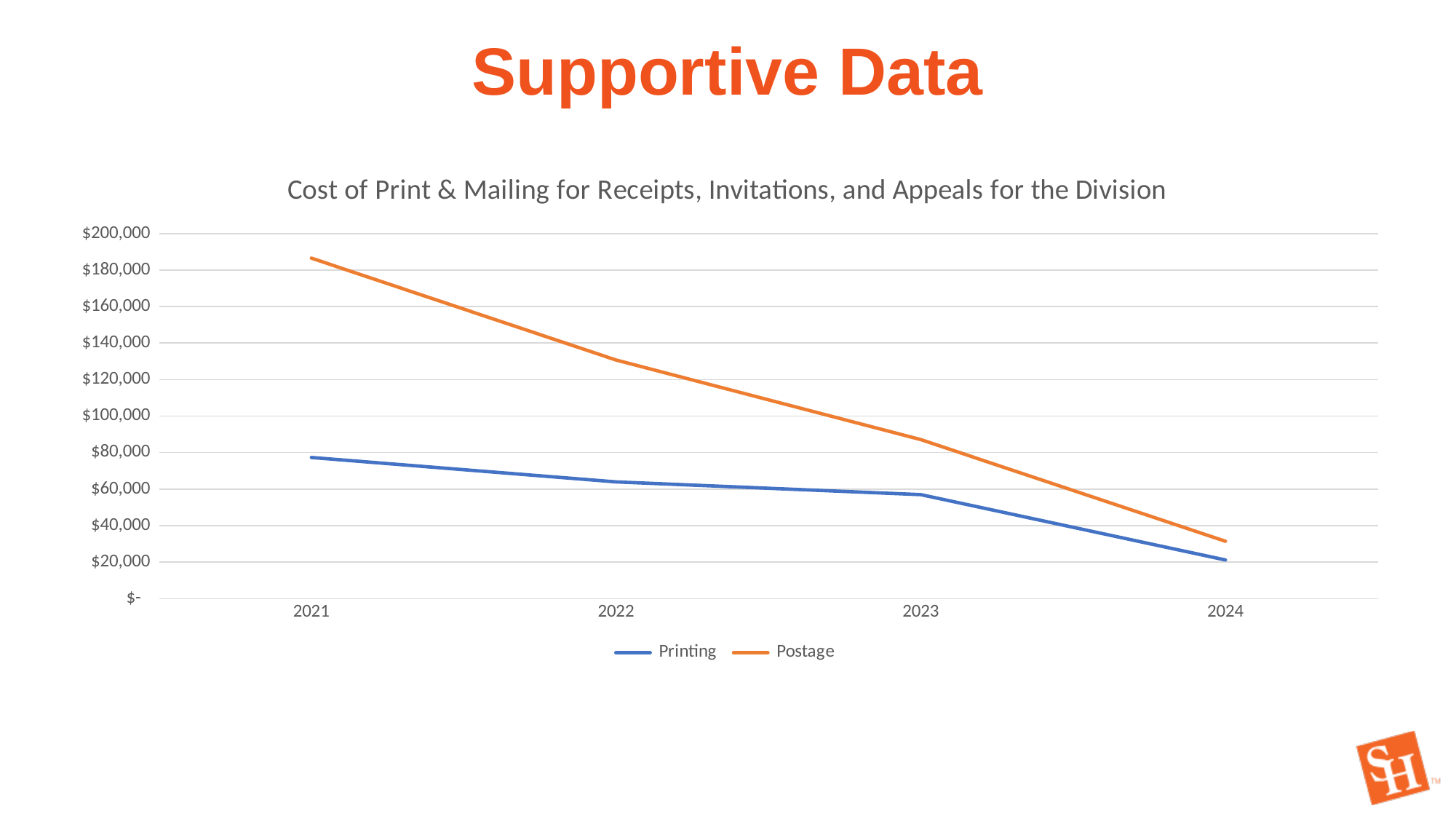
Does the Printing line rise or fall from 2021 to 2024? Fall Is the Printing value for 2024 greater or less than $40,000? less In which year is the Printing cost lowest? 2024 What is the title of the chart? Cost of Print & Mailing for Receipts, Invitations, and Appeals for the Division Does the Postage line rise or fall from 2021 to 2024? Fall In 2021, which is larger, the Printing cost or the Postage cost? Postage Is the Postage value for 2023 greater or less than $100,000? less How many series does the legend list? 2 What kind of chart is shown on the slide? Line chart How many years are plotted along the x axis? 4 In which year is the Postage cost highest? 2021